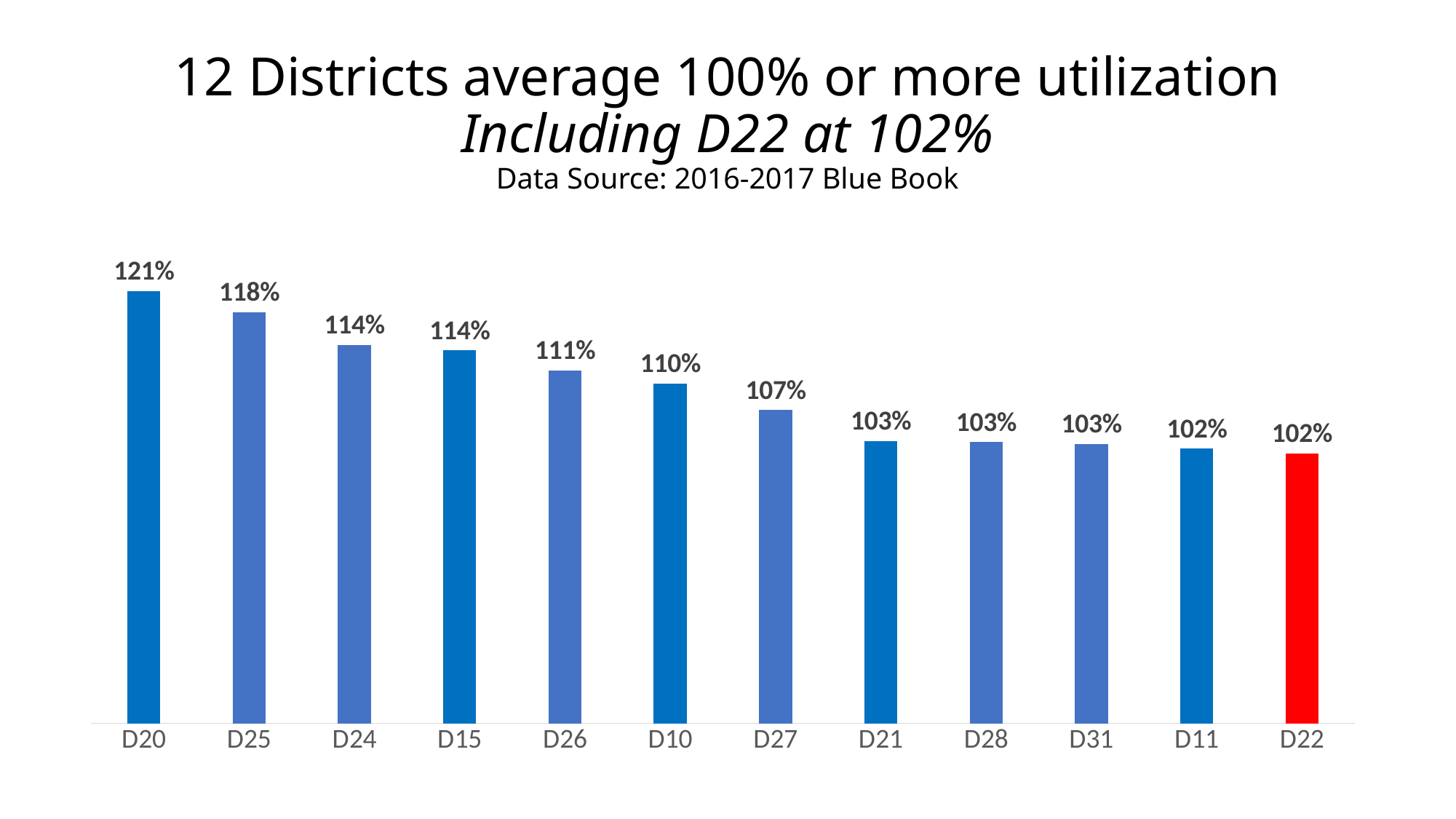
What is the difference between the utilization values for D20 and D25? 3% What is the utilization value for D20? 121% What is the utilization value for D27? 107% Which has a higher utilization, D26 or D21? D26 What kind of chart is shown on the slide? Bar chart Which district's bar is coloured red? D22 Which district has the highest utilization? D20 What is the utilization value for D22? 102% How many districts are shown in the chart? 12 Do the values rise or fall from left to right along the x axis? Fall What is the difference between the utilization values for D10 and D22? 8% Which has a higher utilization, D15 or D27? D15